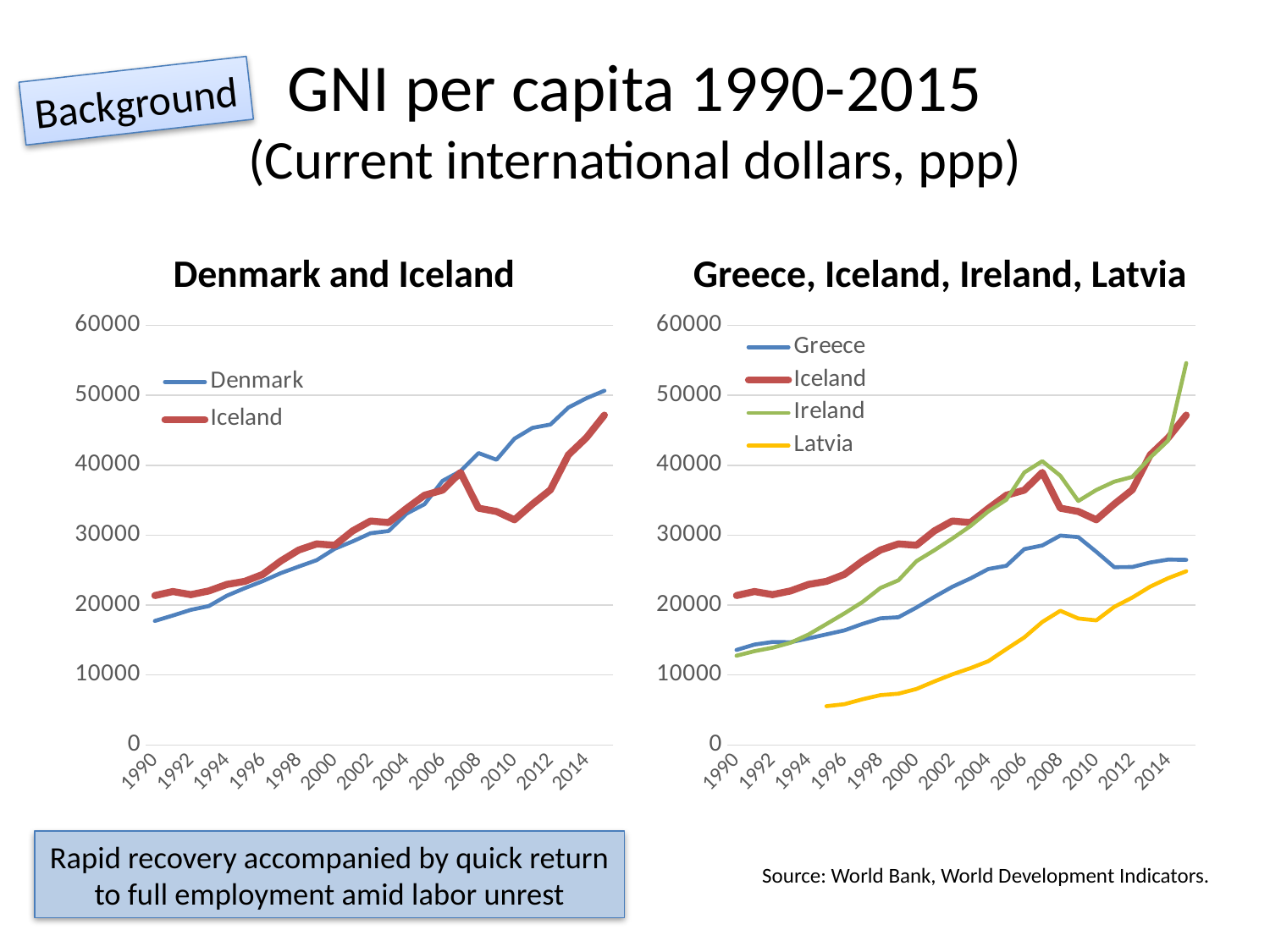
In the 'Greece, Iceland, Ireland, Latvia' chart, is the value for Ireland in 2015 greater or less than 50000? greater In the 'Denmark and Iceland' chart, is the value for Denmark in 1990 greater or less than 20000? less In the 'Denmark and Iceland' chart, does the Denmark line generally rise or fall from 1990 to 2015? rise How many series does the legend of the 'Greece, Iceland, Ireland, Latvia' chart list? 4 What kind of chart is the 'Denmark and Iceland' chart? line chart In the 'Greece, Iceland, Ireland, Latvia' chart, which series has the highest value in 2015? Ireland How many series does the legend of the 'Denmark and Iceland' chart list? 2 In the 'Greece, Iceland, Ireland, Latvia' chart, which is larger in 2015, Greece or Ireland? Ireland What source is cited for the charts on the slide? World Bank, World Development Indicators In the 'Greece, Iceland, Ireland, Latvia' chart, which series has the lowest value in 2000? Latvia In the 'Denmark and Iceland' chart, which is larger in 1990, Denmark or Iceland? Iceland In the 'Denmark and Iceland' chart, is the value for Iceland in 2010 greater or less than 40000? less